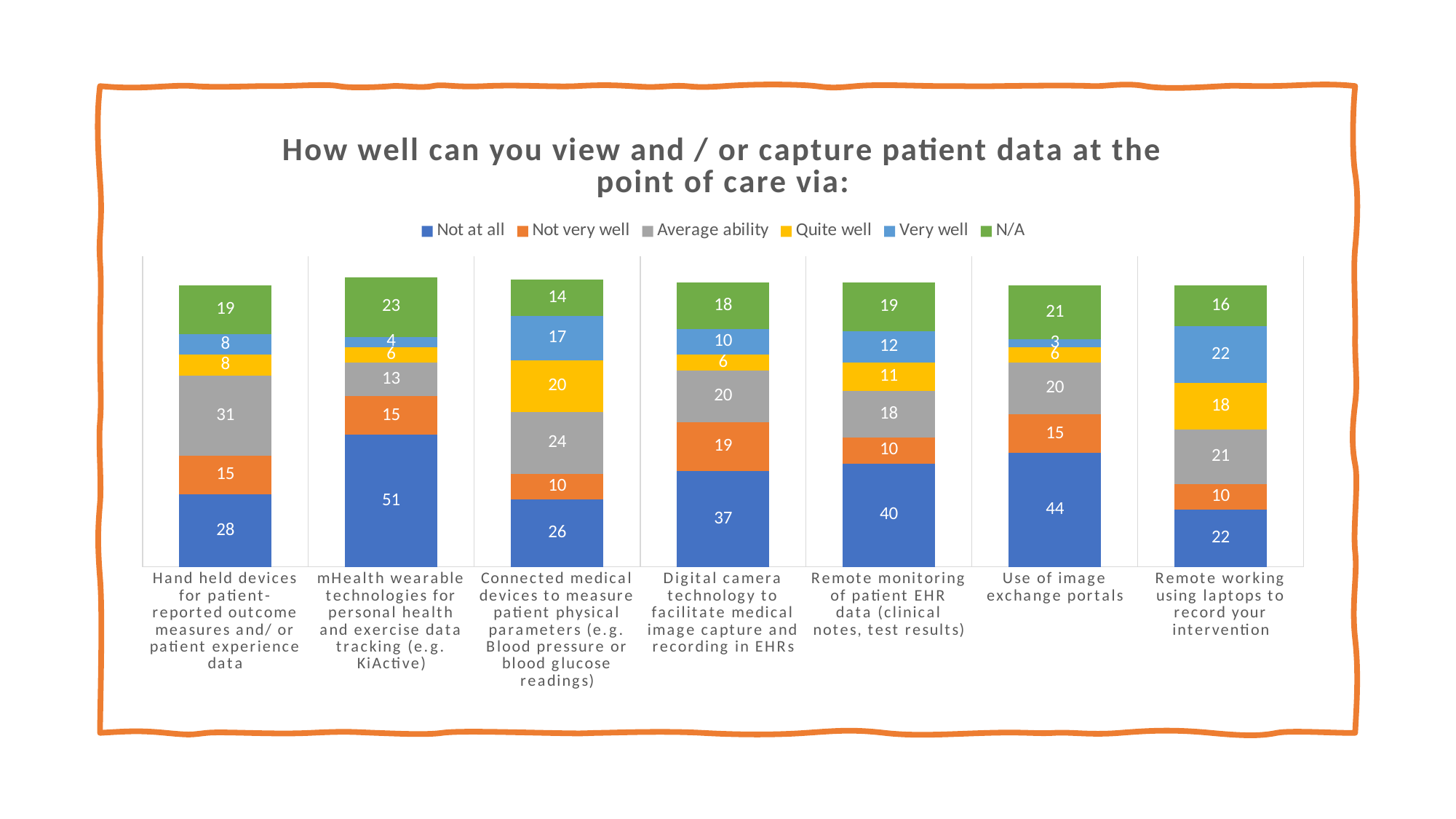
Which is larger: the "Quite well" value for Connected medical devices to measure patient physical parameters or the "Quite well" value for Remote monitoring of patient EHR data? Connected medical devices to measure patient physical parameters Which colour represents the "N/A" series in the legend? Green Which category has the lowest value for "Very well"? Use of image exchange portals What kind of chart is shown on the slide? Stacked bar chart What is the difference between the "Not at all" values for Use of image exchange portals and Digital camera technology to facilitate medical image capture and recording in EHRs? 7 What is the value for "Not at all" for mHealth wearable technologies for personal health and exercise data tracking (e.g. KiActive)? 51 How many categories are shown on the x axis? 7 What is the value for "Average ability" for Hand held devices for patient-reported outcome measures and/ or patient experience data? 31 How many series does the legend list? 6 What is the total of the stacked bar for Connected medical devices to measure patient physical parameters (e.g. Blood pressure or blood glucose readings)? 111 What is the value for "Very well" for Remote working using laptops to record your intervention? 22 Which category has the highest value for "Not at all"? mHealth wearable technologies for personal health and exercise data tracking (e.g. KiActive)